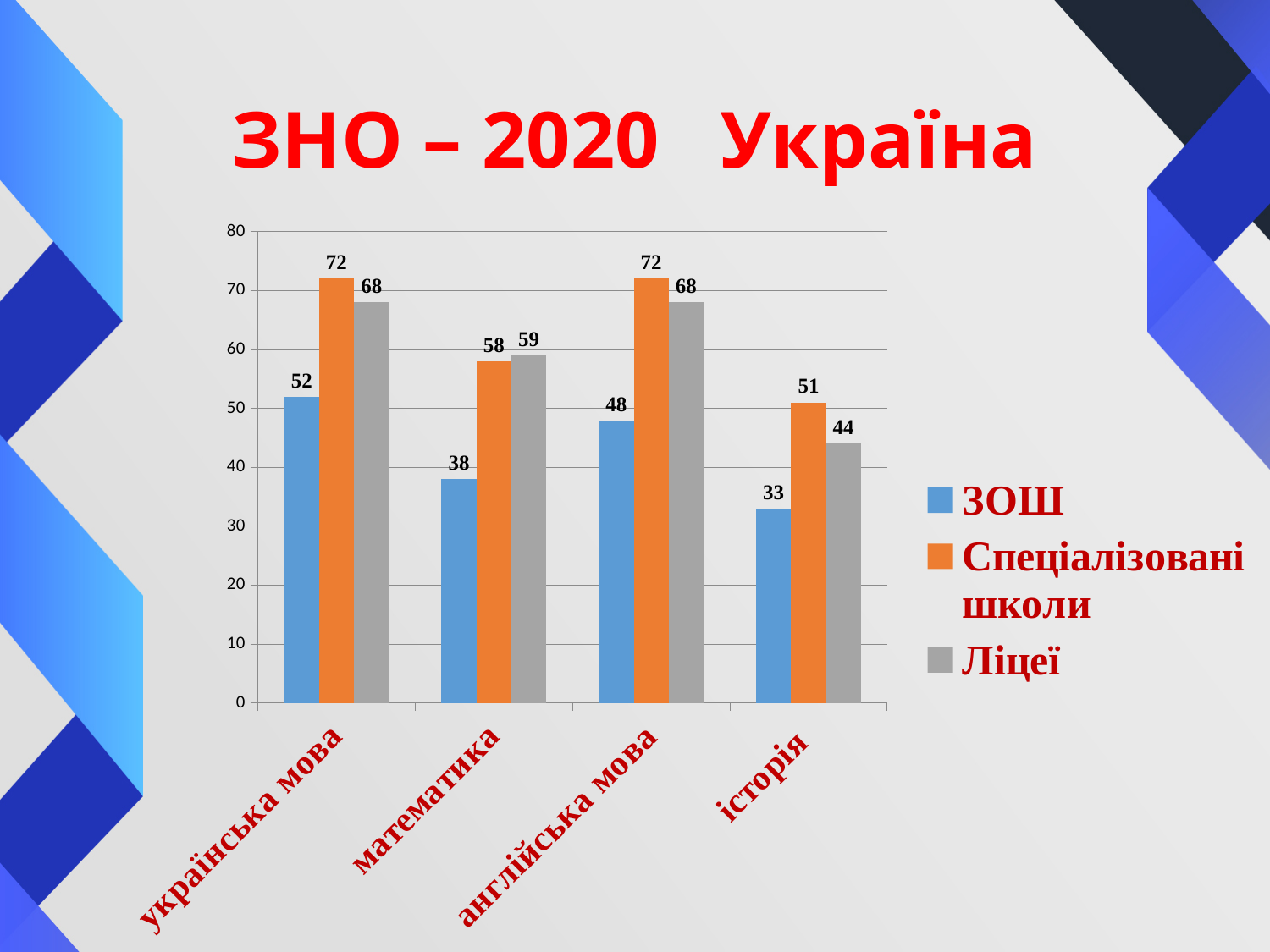
Which is larger in історія: Ліцеї or ЗОШ? Ліцеї What is the difference between Спеціалізовані школи and ЗОШ in математика? 20 What colour represents Спеціалізовані школи in the chart? orange What is the value for Ліцеї in математика? 59 How many categories are shown on the x axis? 4 What is the value for Спеціалізовані школи in історія? 51 Which category has the highest value for Ліцеї? українська мова and англійська мова (both 68) What kind of chart is shown on the slide? bar chart How many series does the legend list? 3 Which category has the lowest value for ЗОШ? історія Is the value for ЗОШ in англійська мова greater or less than 50? less What is the value for ЗОШ in українська мова? 52